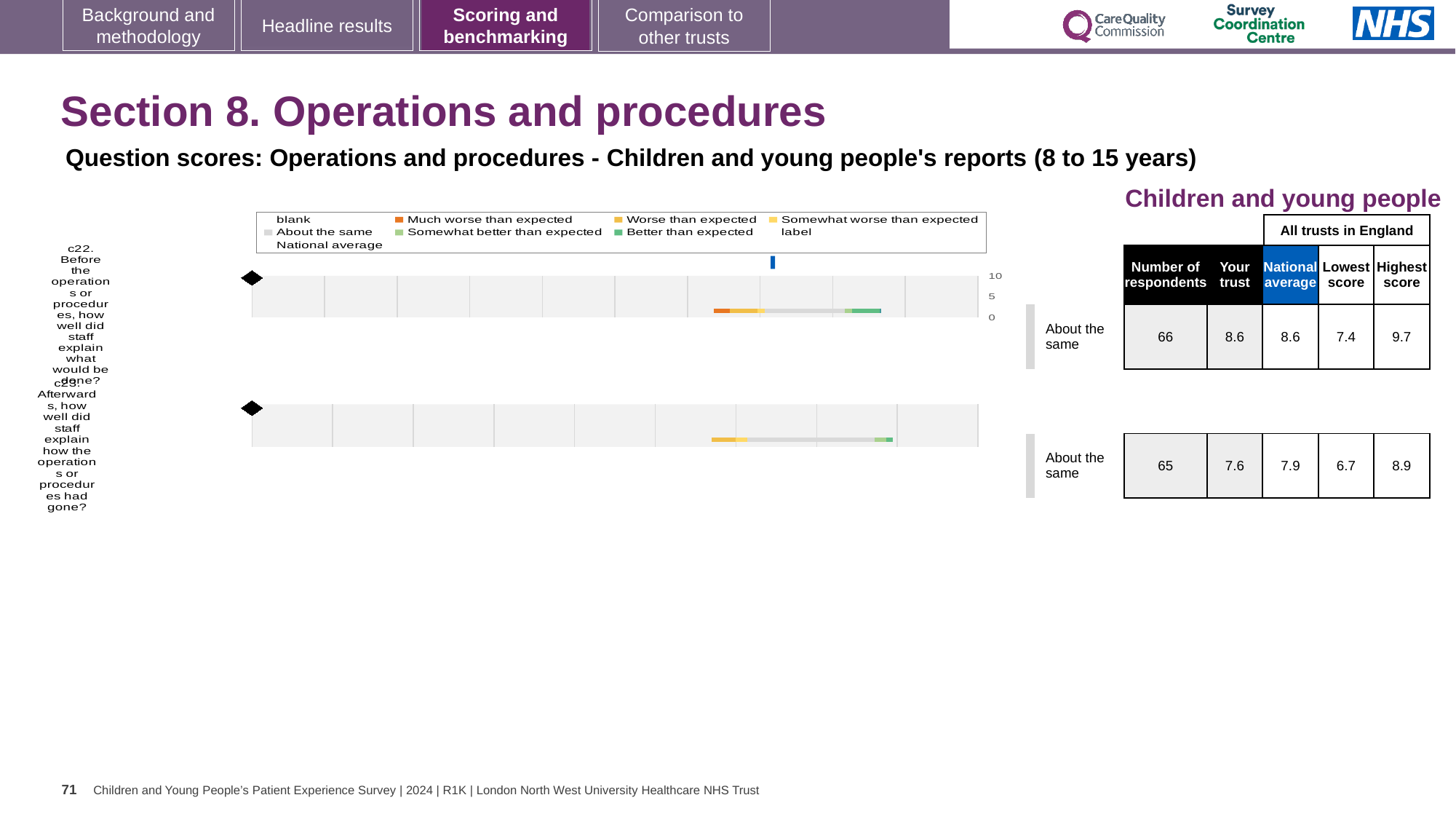
For the c23 chart, what is the highest score among all trusts in England? 8.9 In the chart legend, what colour represents 'Much worse than expected'? orange How many question charts (c22, c23) are shown on the slide? 2 For the c23 chart, what is the difference between the national average (7.9) and the 'Your trust' score (7.6)? 0.3 For the c23 chart, how many respondents are there? 65 Which has the higher 'Your trust' score, the c22 chart or the c23 chart? c22 How many entries does the chart legend list? 9 For the c22 chart, what is the difference between the highest score (9.7) and the lowest score (7.4) across all trusts in England? 2.3 What kind of chart is used to show the question scores for c22 and c23? bar chart For the c22 chart (before the operation, how well did staff explain what would be done), what is the 'Your trust' score? 8.6 For the c22 chart, what is the national average score? 8.6 For the c23 chart (afterwards, how well did staff explain how the operation had gone), what is the 'Your trust' score? 7.6